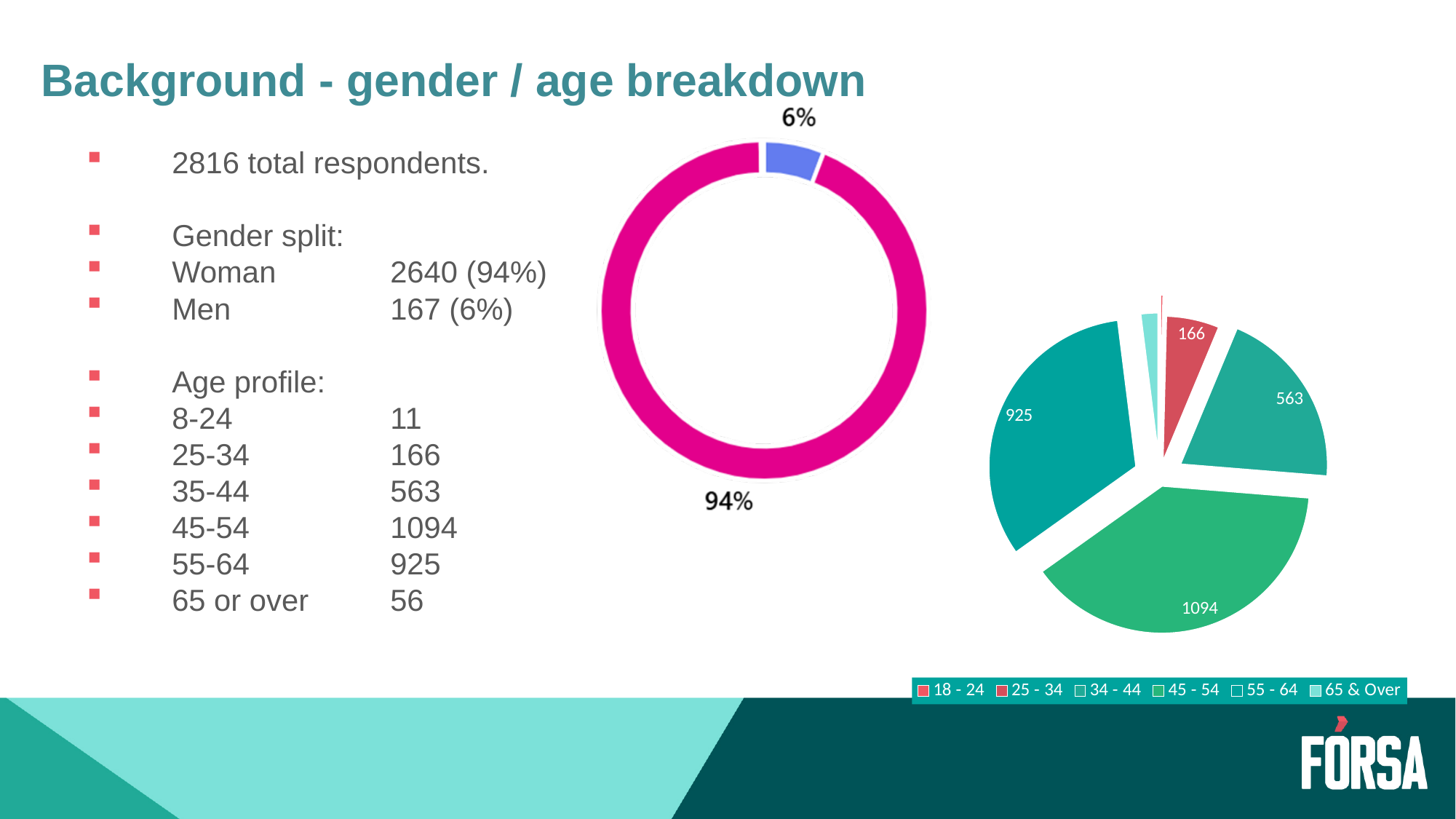
On the pie chart on the right, which age group has the largest slice? 45 - 54 On the pie chart on the right, what is the difference between the 34 - 44 value and the 25 - 34 value? 397 On the pie chart on the right, which is larger: the 55 - 64 slice or the 34 - 44 slice? 55 - 64 On the pie chart on the right, what is the value for the 45 - 54 age group? 1094 On the pie chart on the right, what is the value for the 55 - 64 age group? 925 How many age groups does the legend of the pie chart on the right list? 6 On the pie chart on the right, what is the difference between the 45 - 54 value and the 55 - 64 value? 169 On the pie chart on the right, what is the value for the 25 - 34 age group? 166 On the doughnut chart in the centre of the slide, what share does the smaller (blue) segment represent? 6% On the pie chart on the right, which age group has the smallest slice? 18 - 24 On the doughnut chart in the centre of the slide, what share does the larger (pink) segment represent? 94% What kind of chart is the chart in the centre of the slide showing 94% and 6%? Doughnut chart